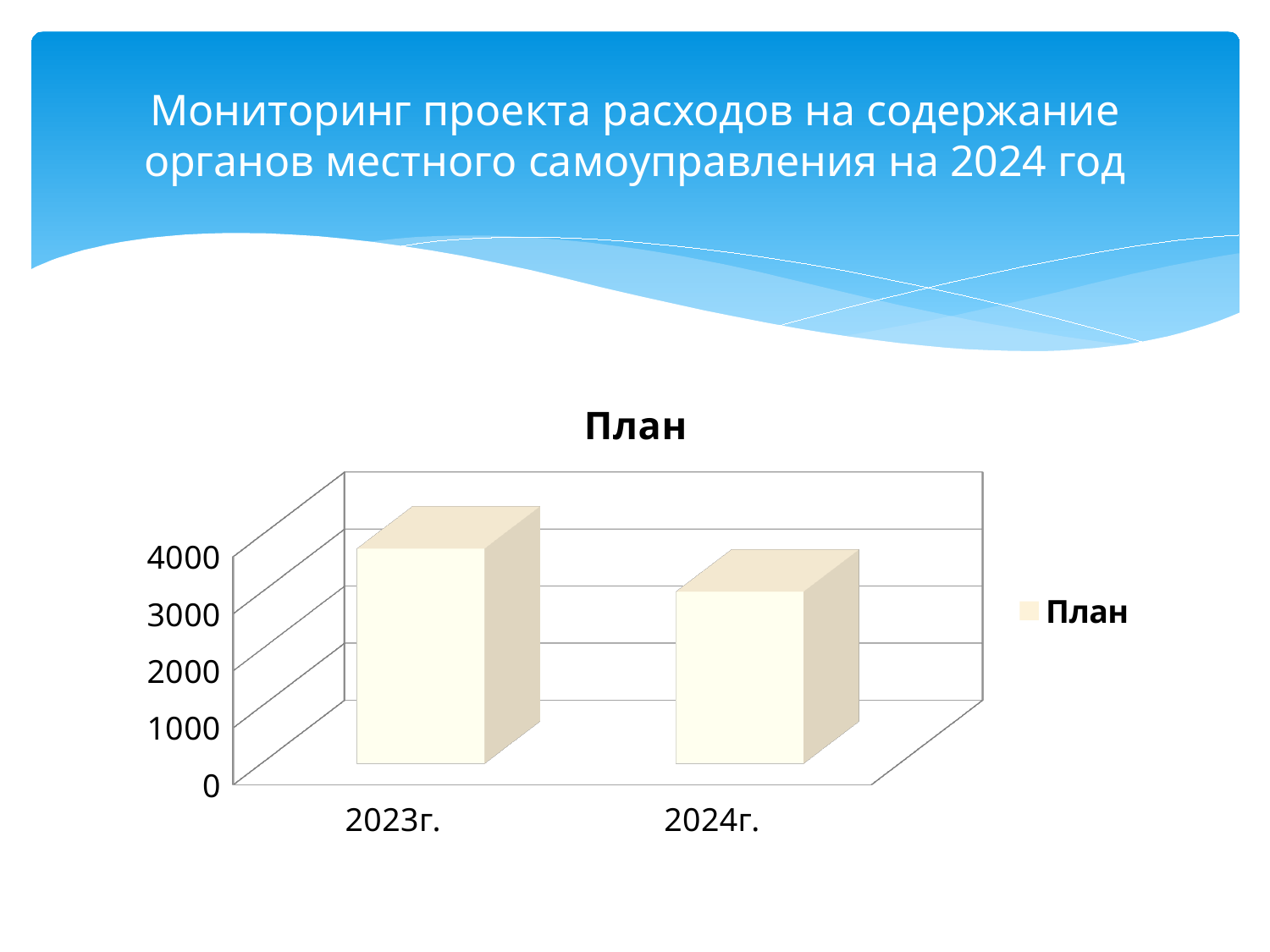
How many categories are shown on the x axis of the chart? 2 Is the value for 2024г. greater or less than 2000? greater What kind of chart is shown on the slide? bar chart Is the value for 2024г. greater or less than 4000? less What is the title of the chart? План Which year has the highest value in the chart? 2023г. What is the name of the series listed in the legend? План Is the value for 2023г. greater or less than 3000? greater Do the values rise or fall from 2023г. to 2024г.? fall How many series does the chart's legend list? 1 Which is larger, the value for 2023г. or the value for 2024г.? 2023г. Which year has the lowest value in the chart? 2024г.